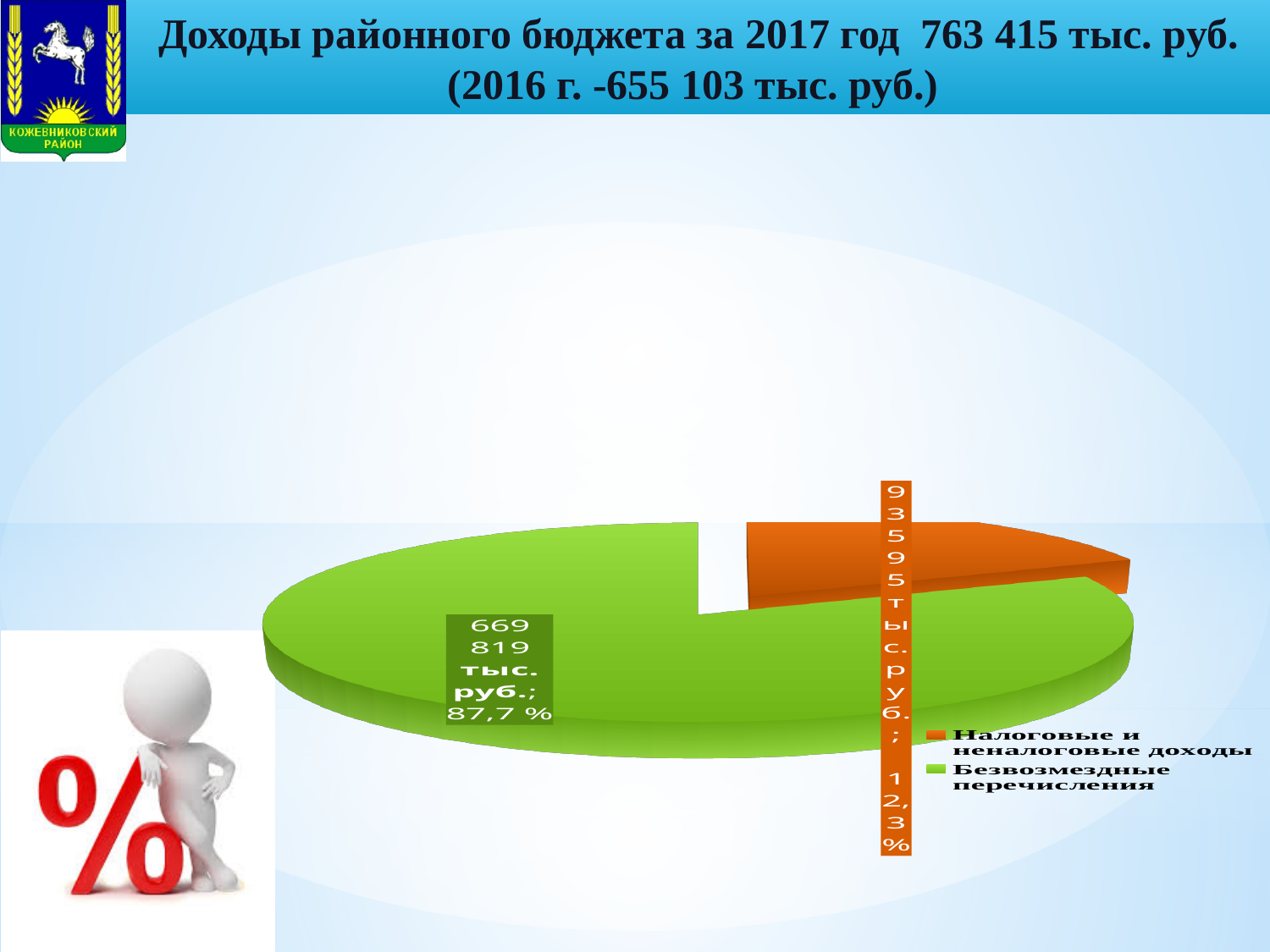
What value is shown for Безвозмездные перечисления? 669 819 тыс. руб. Which is larger, Безвозмездные перечисления or Налоговые и неналоговые доходы? Безвозмездные перечисления Which slice is the largest? Безвозмездные перечисления What value is shown for Налоговые и неналоговые доходы? 93 595 тыс. руб. What colour is the slice for Налоговые и неналоговые доходы? orange Which slice is the smallest? Налоговые и неналоговые доходы What kind of chart is shown on the slide? pie chart How many series does the legend list? 2 What share of the pie is Налоговые и неналоговые доходы? 12,3% What is the difference in percentage points between the shares of Безвозмездные перечисления and Налоговые и неналоговые доходы? 75,4 What share of the pie is Безвозмездные перечисления? 87,7 % How many slices does the pie chart have? 2